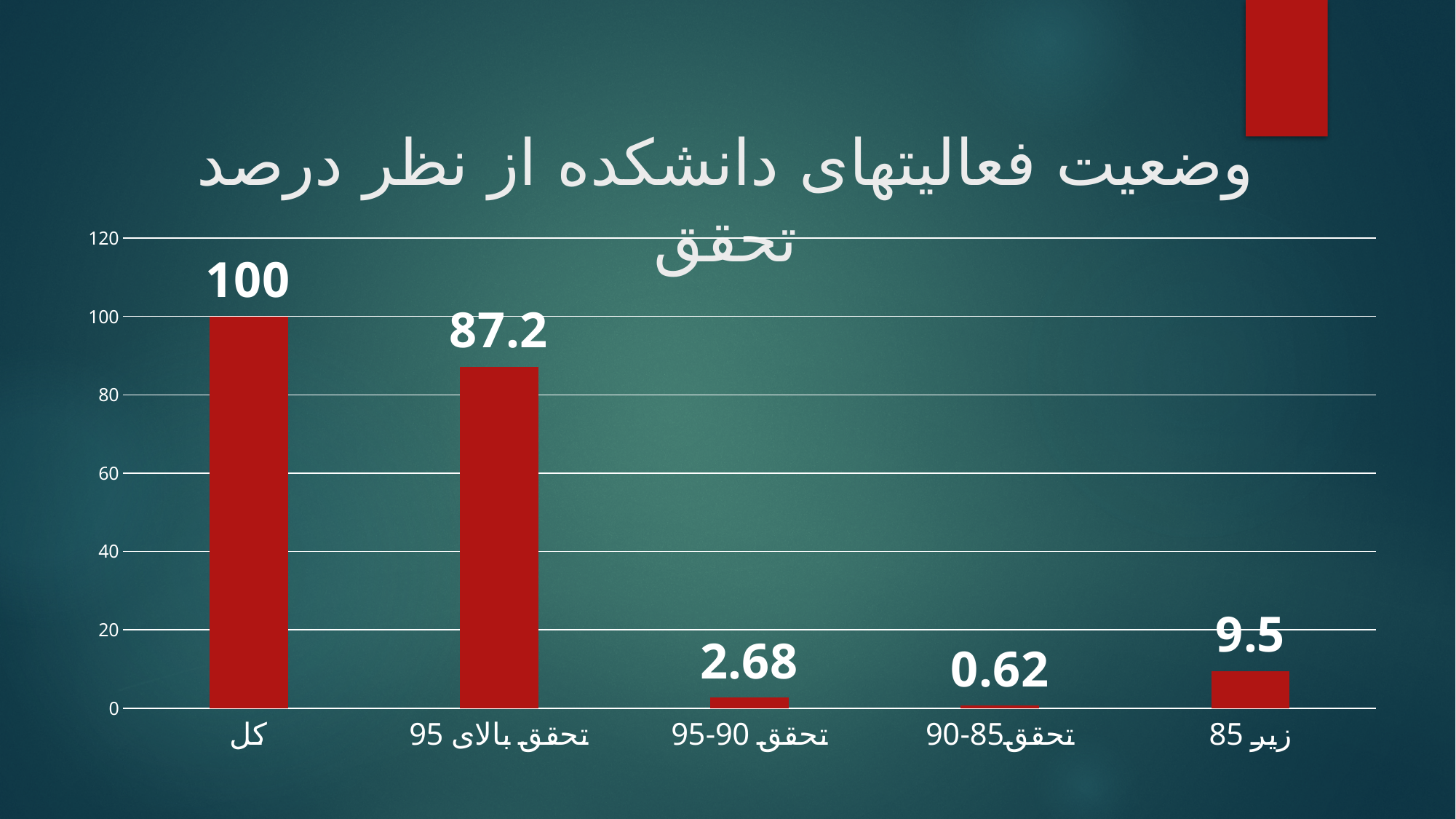
What is the value for the category "تحقق 90-85"? 0.62 What kind of chart is shown on the slide? bar chart Which is larger, the value for "زیر 85" or the value for "تحقق 95-90"? زیر 85 What is the value for the category "زیر 85"? 9.5 How many categories are shown on the x axis? 5 What is the value for the category "تحقق 95-90"? 2.68 Which category has the lowest value? تحقق 90-85 What colour are the bars in the chart? red What is the difference between the values for "کل" and "تحقق بالای 95"? 12.8 Which category has the highest value? کل What is the value for the category "تحقق بالای 95"? 87.2 What is the value for the category "کل"? 100